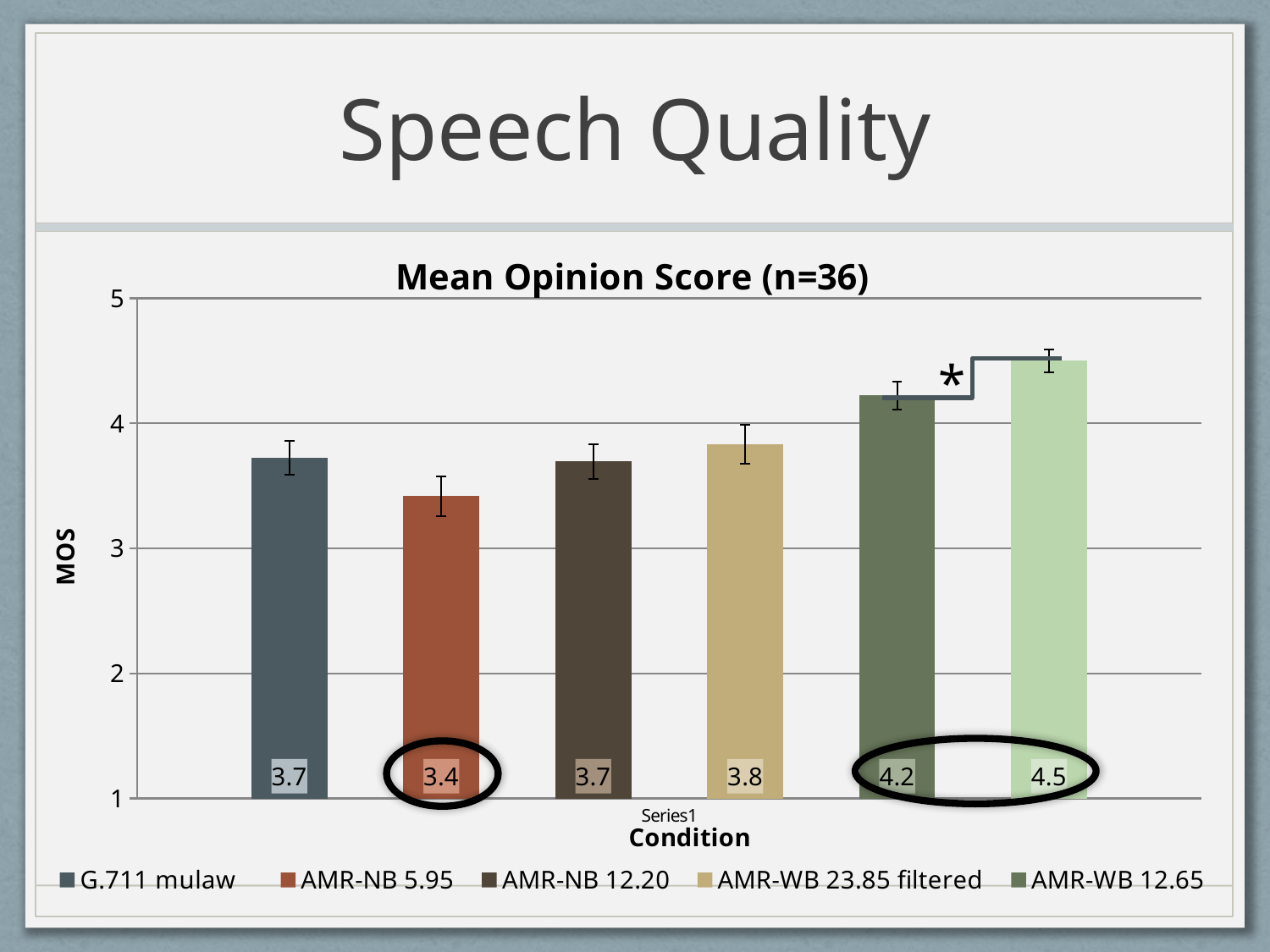
Is the Mean Opinion Score for AMR-WB 12.65 greater or less than 4? greater Which condition has the lowest Mean Opinion Score? AMR-NB 5.95 What type of chart is shown on the slide? bar chart How many bars are plotted in the chart? 6 What is the highest Mean Opinion Score value labelled on the chart? 4.5 Which has a higher Mean Opinion Score, AMR-WB 23.85 filtered or AMR-NB 12.20? AMR-WB 23.85 filtered What is the difference between the Mean Opinion Score for AMR-WB 12.65 and AMR-NB 5.95? 0.8 What is the Mean Opinion Score for G.711 mulaw? 3.7 What is the Mean Opinion Score for AMR-NB 5.95? 3.4 What is the Mean Opinion Score for AMR-WB 12.65? 4.2 How many entries does the chart legend list? 5 What is the Mean Opinion Score for AMR-WB 23.85 filtered? 3.8